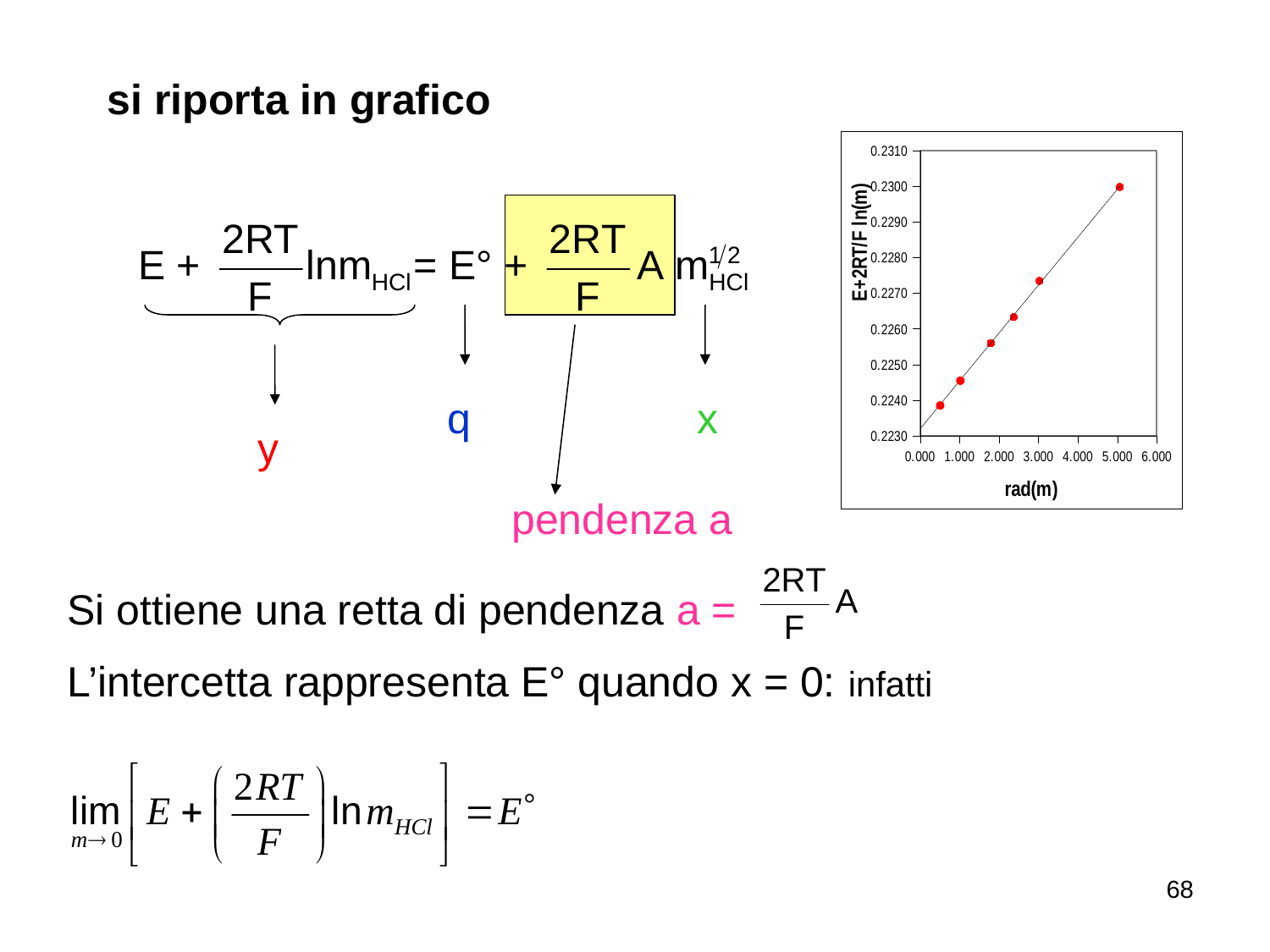
Is the value of the data point near rad(m) = 3.000 greater or less than 0.2260? greater What is the title of the x axis of the chart? rad(m) Do the plotted values rise or fall as rad(m) increases along the x axis? rise How many data points are plotted in the chart? 6 What kind of chart is shown on the slide? scatter chart Is the value of the rightmost data point (near rad(m) = 5.000) greater or less than 0.2290? greater What is the highest value shown on the y axis of the chart? 0.2310 What is the title of the y axis of the chart? E+2RT/F ln(m) Which data point has the highest y value: the one near rad(m) = 1.000 or the one near rad(m) = 5.000? the one near rad(m) = 5.000 Is the value of the leftmost data point greater or less than 0.2250? less